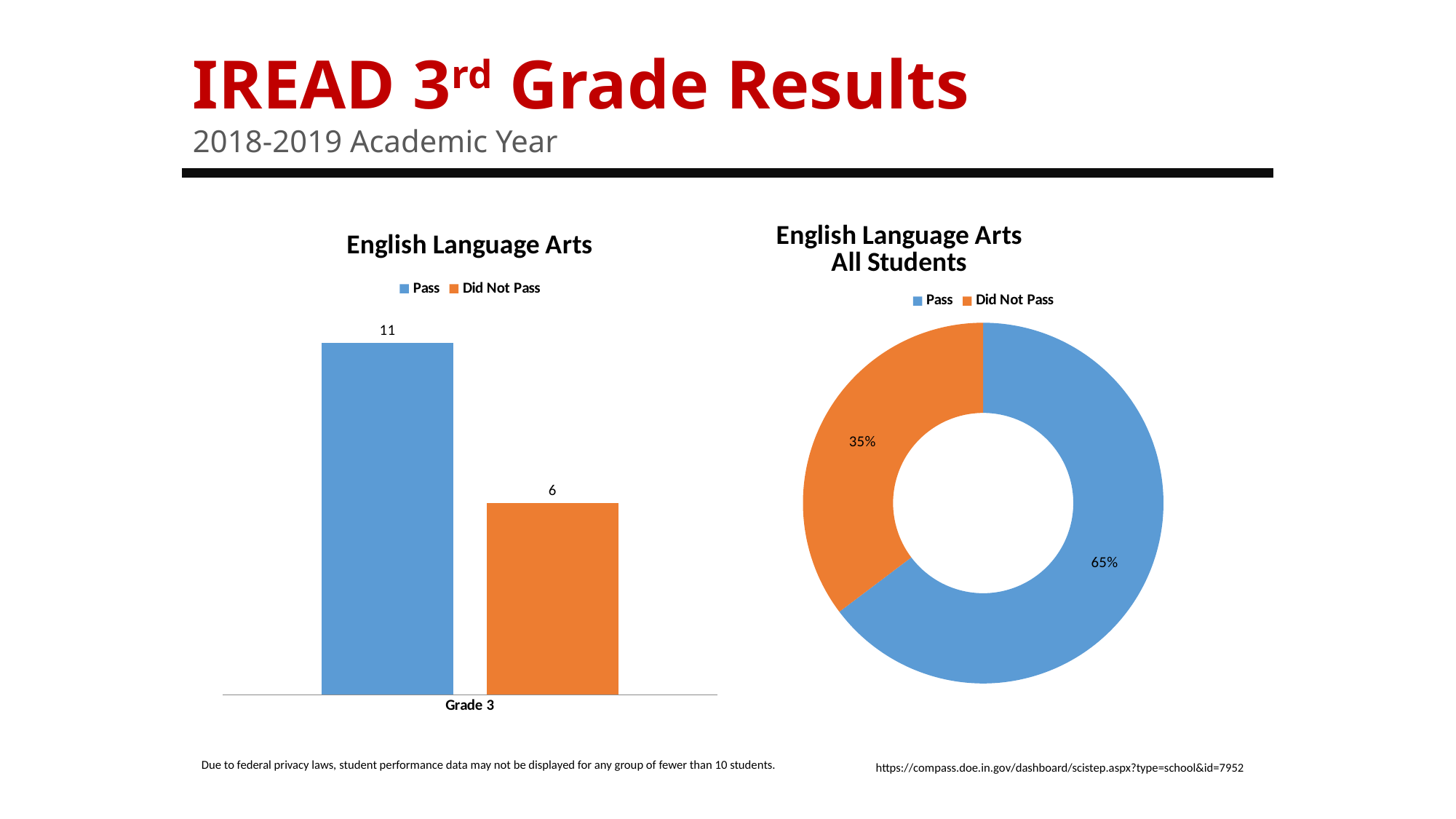
In the 'English Language Arts' bar chart, what is the value for Pass in Grade 3? 11 In the 'English Language Arts All Students' chart, which slice is larger, Pass or Did Not Pass? Pass In the 'English Language Arts' bar chart, what colour is the Did Not Pass bar? Orange In the 'English Language Arts All Students' chart, what share of students is Pass? 65% In the 'English Language Arts All Students' chart, what share of students is Did Not Pass? 35% In the 'English Language Arts' bar chart, how many series does the legend list? 2 What kind of chart is the 'English Language Arts All Students' chart on the right? Doughnut chart What kind of chart is the 'English Language Arts' chart on the left? Bar chart In the 'English Language Arts' bar chart, what is the value for Did Not Pass in Grade 3? 6 In the 'English Language Arts' bar chart, which series has the higher value for Grade 3? Pass In the 'English Language Arts' bar chart, what is the difference between the Pass and Did Not Pass values? 5 In the 'English Language Arts' bar chart, which series has the lower value for Grade 3? Did Not Pass